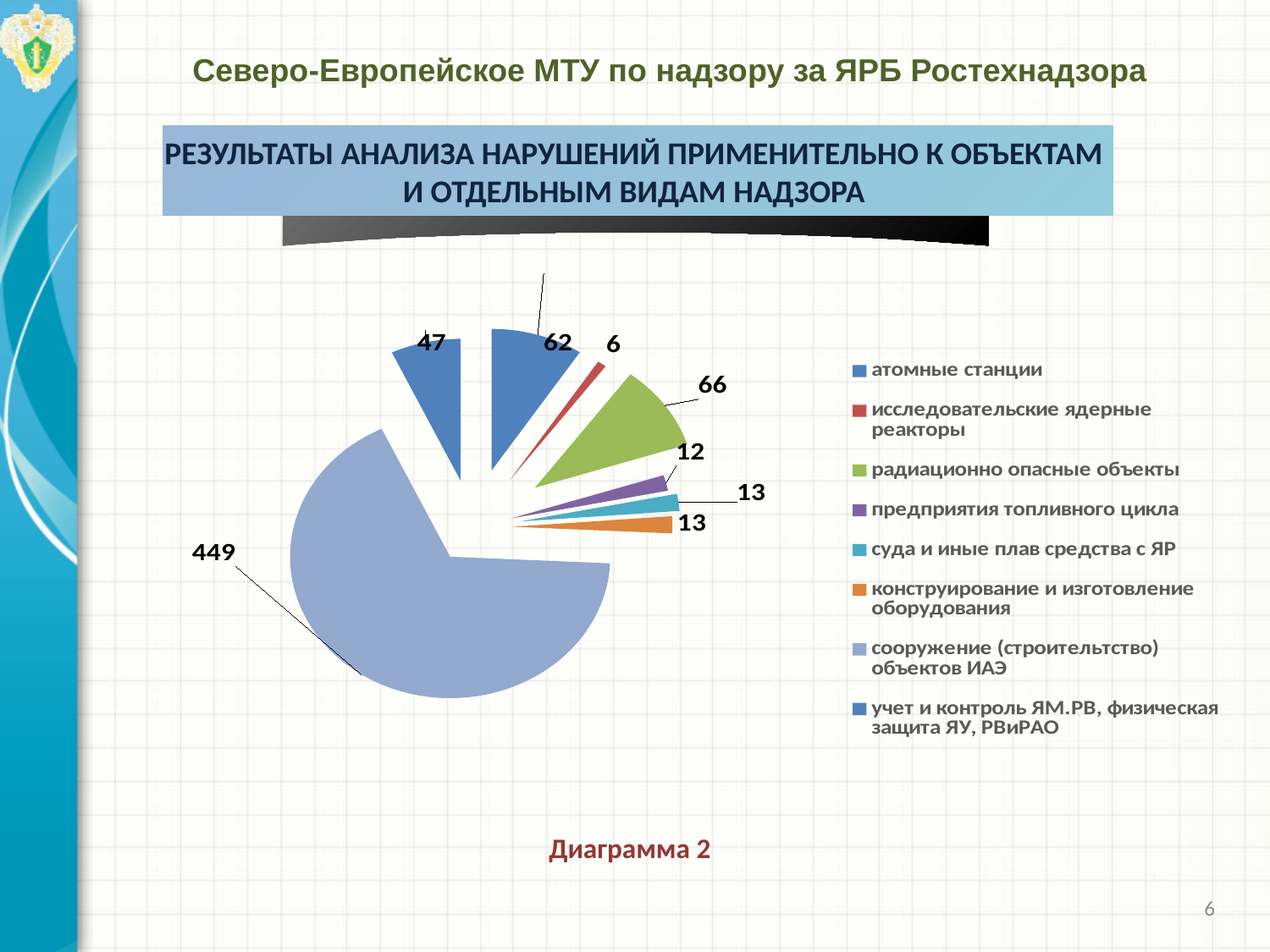
What is the value for 'атомные станции'? 62 What kind of chart is shown on the slide? pie chart Which category has the largest slice of the pie? сооружение (строительство) объектов ИАЭ What is the caption printed below the pie chart? Диаграмма 2 How many categories does the legend of the pie chart list? 8 What is the difference between the values for 'радиационно опасные объекты' and 'атомные станции'? 4 What is the value for 'исследовательские ядерные реакторы'? 6 Which is larger: the value for 'атомные станции' or the value for 'учет и контроль ЯМ.РВ, физическая защита ЯУ, РВиРАО'? атомные станции Which category has the smallest slice of the pie? исследовательские ядерные реакторы What is the value for 'радиационно опасные объекты'? 66 What is the value for 'сооружение (строительство) объектов ИАЭ'? 449 What is the value for 'предприятия топливного цикла'? 12